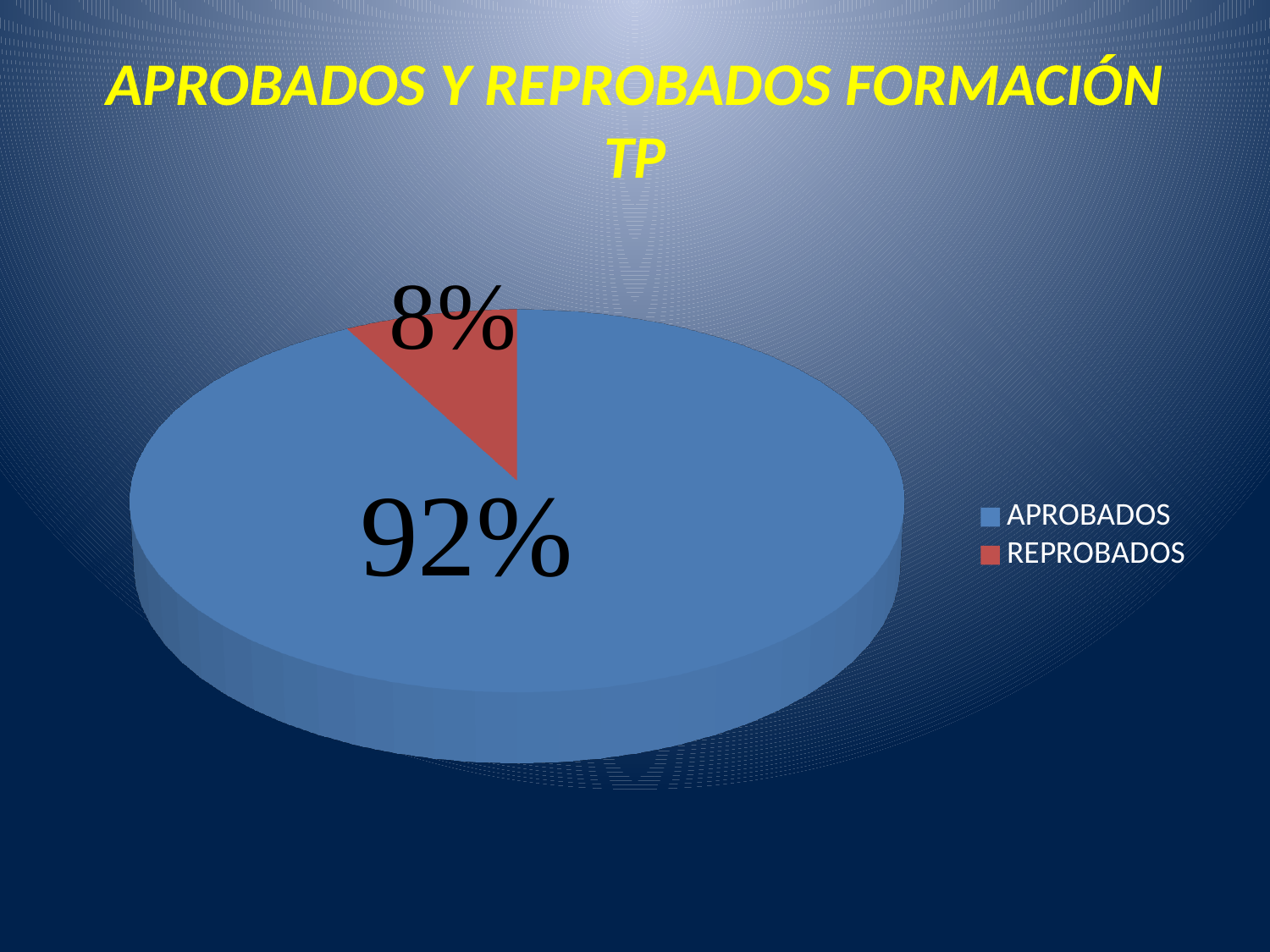
What is the difference in percentage points between APROBADOS and REPROBADOS? 84 What is the title of the chart? APROBADOS Y REPROBADOS FORMACIÓN TP Which is larger, the share for APROBADOS or the share for REPROBADOS? APROBADOS What percentage of the pie is APROBADOS? 92% What share of the pie does the REPROBADOS slice represent? 8% What percentage of the pie is REPROBADOS? 8% What colour is the REPROBADOS slice? Red How many categories does the pie chart show? 2 Which category has the largest share of the pie? APROBADOS Which category has the smallest share of the pie? REPROBADOS What kind of chart is shown on the slide? Pie chart How many entries does the legend list? 2